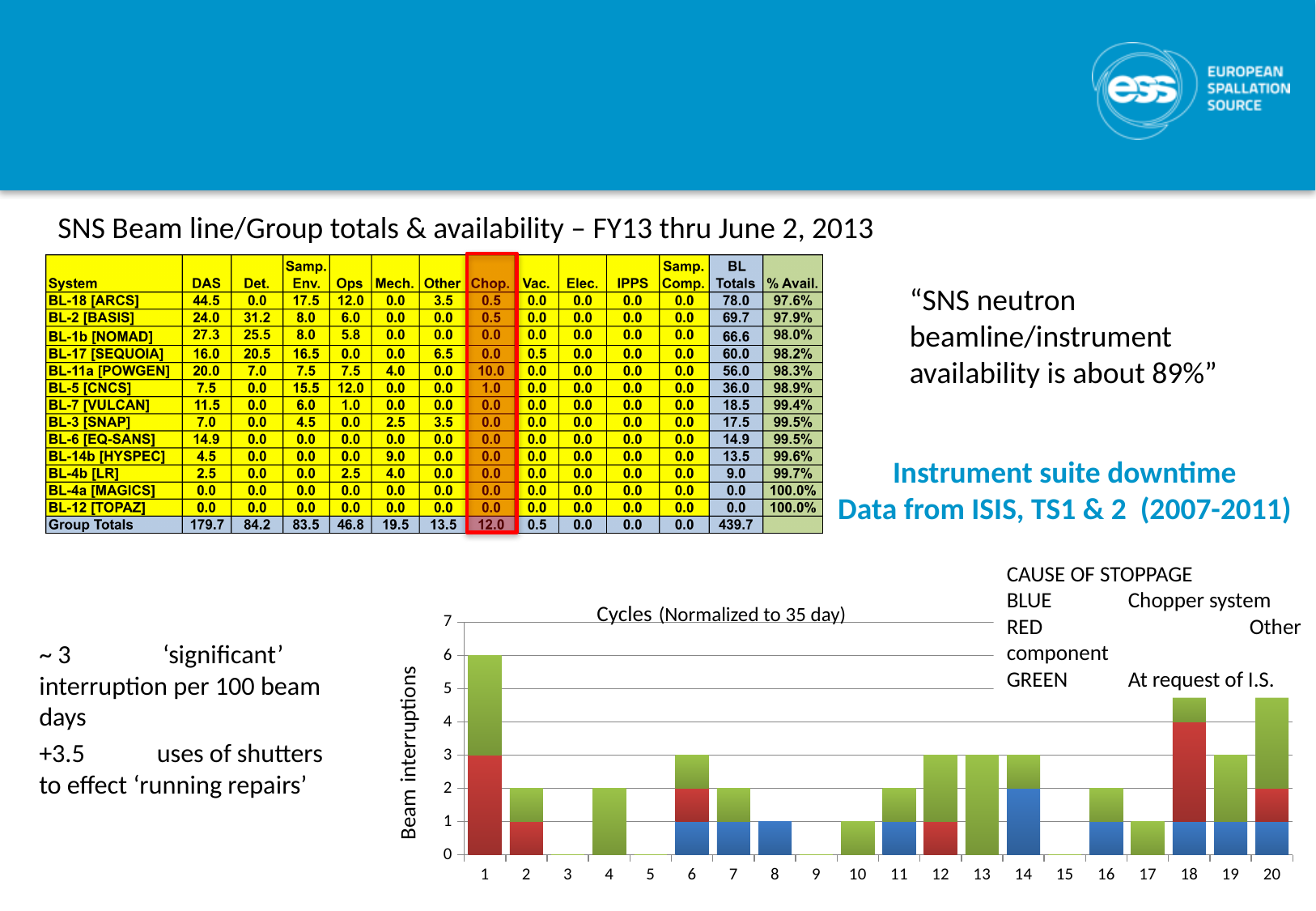
What is the label of the y axis on the "Cycles (Normalized to 35 day)" chart? Beam interruptions According to the "CAUSE OF STOPPAGE" key, what does the green colour in the chart represent? At request of I.S. In the "Cycles (Normalized to 35 day)" chart, is the total for cycle 13 greater or less than 2? greater In the "Cycles (Normalized to 35 day)" chart, what is the difference between the total beam interruptions of cycle 1 and cycle 20? 1 How many cycles are shown on the x axis of the "Cycles (Normalized to 35 day)" chart? 20 In the "Cycles (Normalized to 35 day)" chart, how many beam interruptions does the blue (chopper system) segment show for cycle 14? 2 In the "Cycles (Normalized to 35 day)" chart, what is the total number of beam interruptions for cycle 18? 5 In the "Cycles (Normalized to 35 day)" chart, how many beam interruptions does the red (other component) segment show for cycle 18? 3 In the "Cycles (Normalized to 35 day)" chart, which has more total beam interruptions, cycle 12 or cycle 8? Cycle 12 In the "Cycles (Normalized to 35 day)" chart, which cycle has the highest total number of beam interruptions? Cycle 1 In the "Cycles (Normalized to 35 day)" chart, what is the total number of beam interruptions for cycle 1? 6 What kind of chart is the "Cycles (Normalized to 35 day)" chart? Stacked bar chart